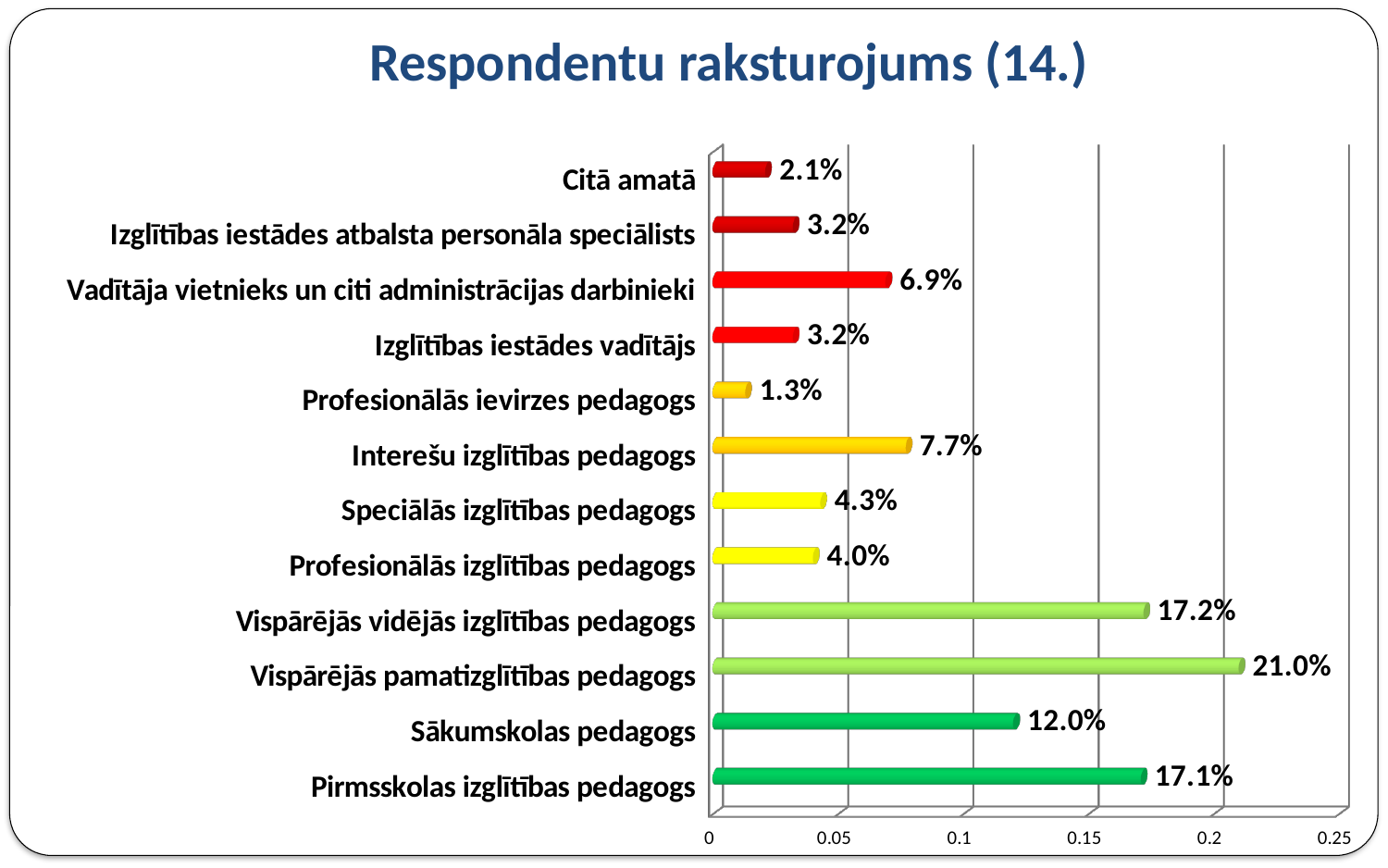
What is the value for Sākumskolas pedagogs? 12.0% Is the value for Vispārējās vidējās izglītības pedagogs greater or less than 0.15? greater What is the value for Vispārējās pamatizglītības pedagogs? 21.0% What is the title of the slide? Respondentu raksturojums (14.) How many categories are shown in the chart? 12 Which category has the lowest value? Profesionālās ievirzes pedagogs What is the difference between the values for Vispārējās pamatizglītības pedagogs and Sākumskolas pedagogs? 9.0% Which category has the highest value? Vispārējās pamatizglītības pedagogs What is the value for Citā amatā? 2.1% What is the value for Interešu izglītības pedagogs? 7.7% Which is larger, the value for Vadītāja vietnieks un citi administrācijas darbinieki or the value for Interešu izglītības pedagogs? Interešu izglītības pedagogs What kind of chart is shown on the slide? bar chart